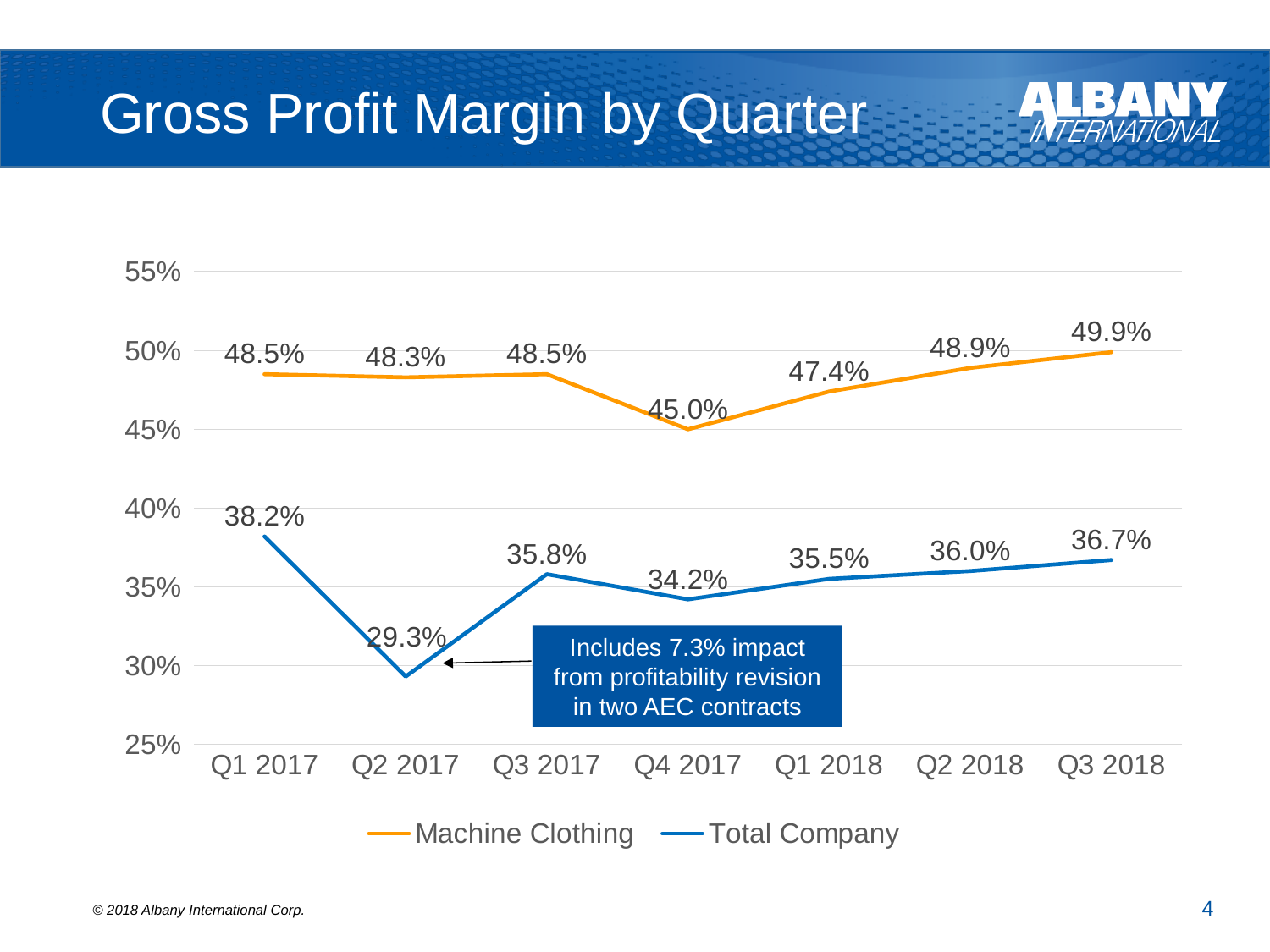
In which quarter is the Total Company gross profit margin lowest? Q2 2017 In which quarter is the Machine Clothing gross profit margin highest? Q3 2018 What is the Total Company gross profit margin in Q2 2017? 29.3% How many quarters are shown on the x axis? 7 What is the Machine Clothing gross profit margin in Q4 2017? 45.0% What kind of chart is shown on the slide? Line chart Is the Machine Clothing value for Q1 2018 greater or less than 45%? greater Does the Total Company gross profit margin rise or fall from Q4 2017 to Q3 2018? Rise What is the Total Company gross profit margin in Q3 2018? 36.7% What is the difference between the Machine Clothing and Total Company gross profit margins in Q3 2018? 13.2% How many series does the legend list? 2 Which is larger, the Total Company margin in Q1 2017 or in Q3 2018? Q1 2017